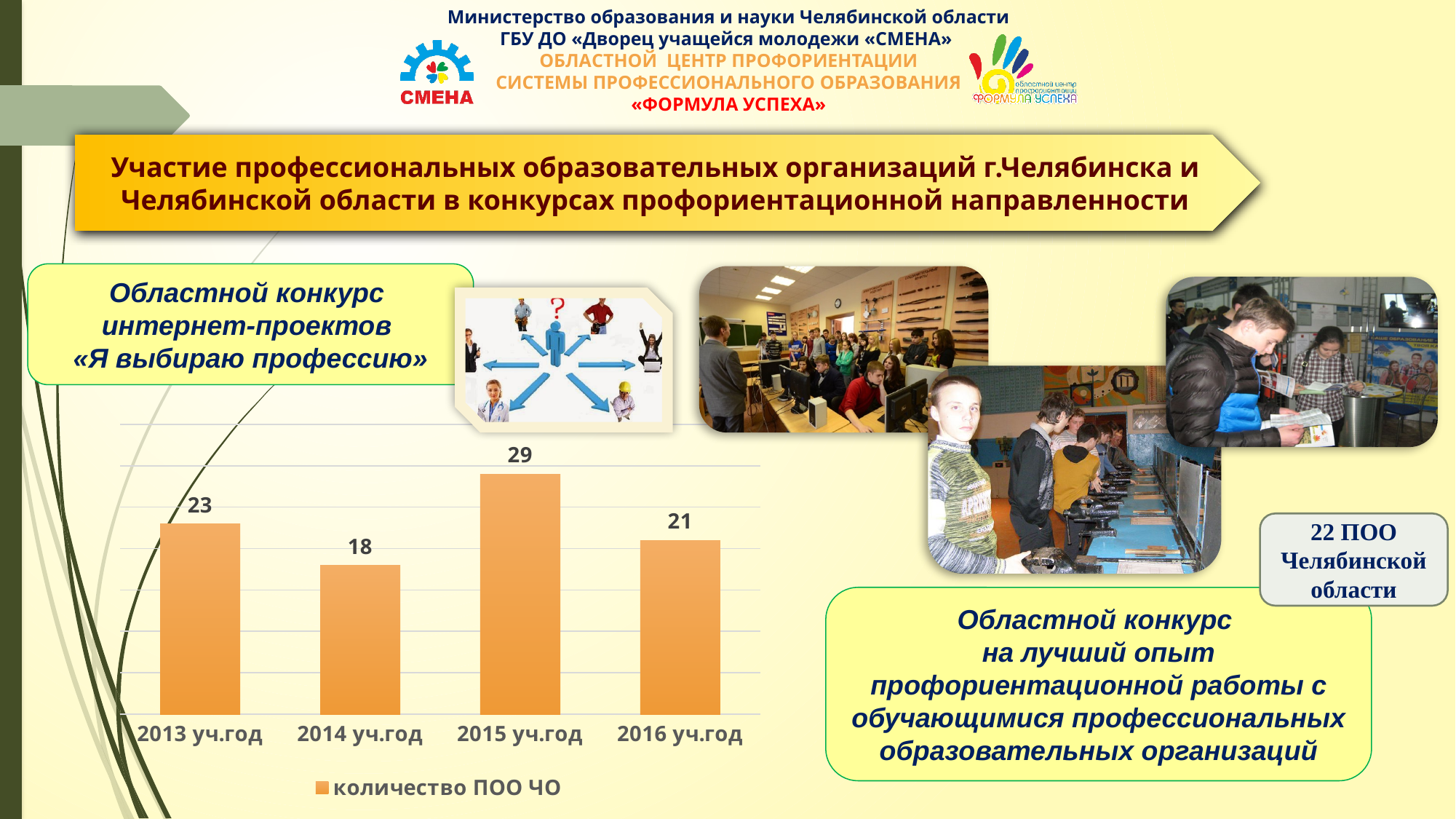
Which is larger, the value for 2013 уч.год or 2016 уч.год? 2013 уч.год How many series does the chart legend list? 1 Which year has the highest value? 2015 уч.год What kind of chart is shown on the slide? bar chart What is the difference between the values for 2015 уч.год and 2014 уч.год? 11 What is the value for 2015 уч.год? 29 What is the value for 2014 уч.год? 18 How many categories are shown on the x axis of the chart? 4 What is the legend entry of the chart? количество ПОО ЧО Which year has the lowest value? 2014 уч.год What is the value for 2013 уч.год? 23 What is the value for 2016 уч.год? 21